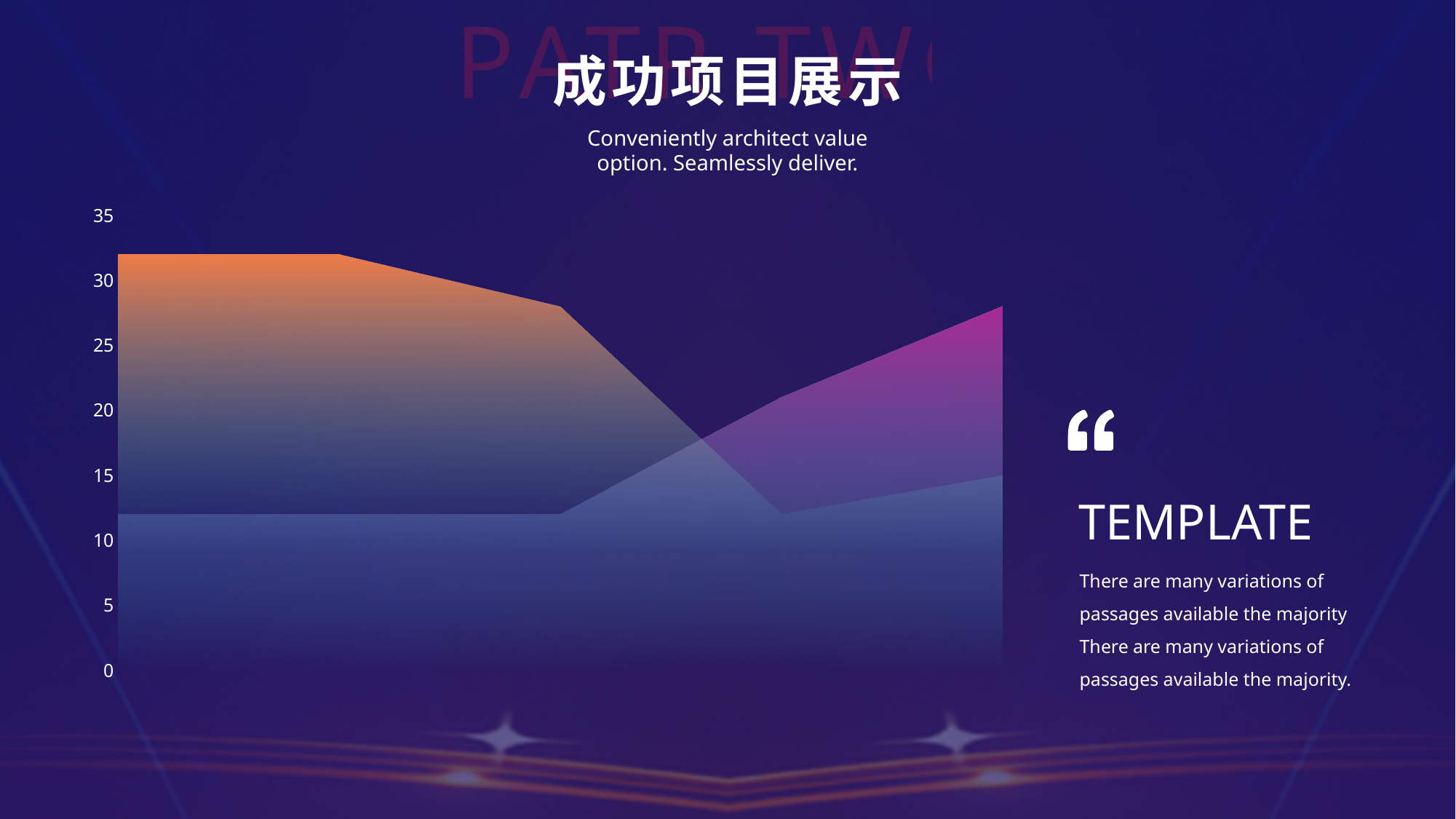
What kind of chart is shown on the slide? area chart What is the title shown above the chart on the slide? 成功项目展示 Is the value of the lower (blue) series at the last point greater or less than 10? greater What is the highest tick value shown on the vertical axis of the chart? 35 How many series are plotted in the area chart? 2 Is the value of the upper (orange) series at the fourth point greater or less than 15? less Does the lower (blue) series rise or fall from the fourth point to the last point? rises How many data points does each series in the area chart have? 5 Is the value of the lower (blue) series at the first point greater or less than 15? less At the first point, which series has the larger value, the upper (orange) series or the lower (blue) series? the upper (orange) series Does the upper (orange) series rise or fall from the first point to the fourth point? falls